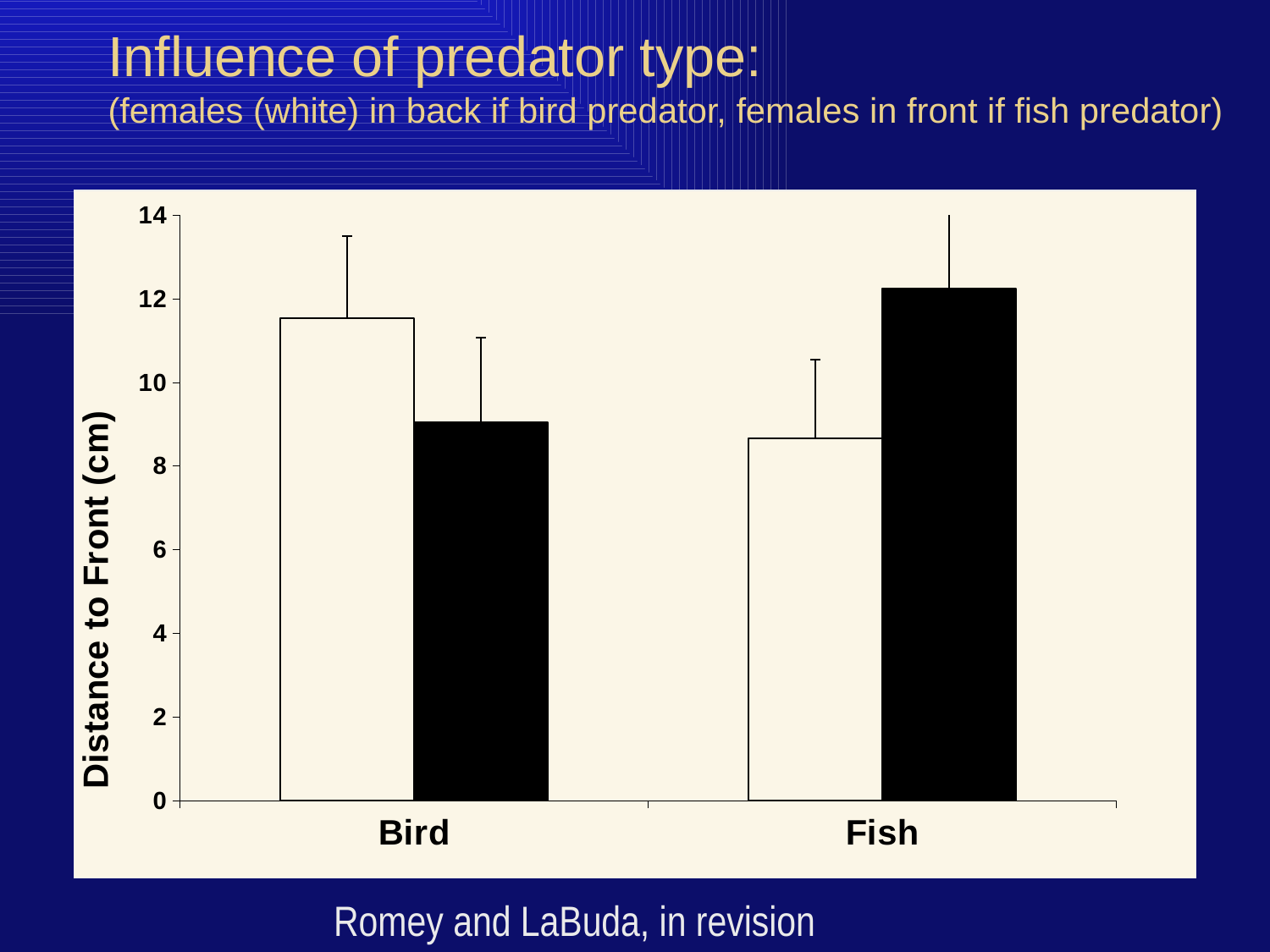
Is the value of the white bar for Fish greater or less than 10? less How many predator-type categories are shown on the x axis? 2 What are the two categories on the x axis? Bird and Fish Is the value of the black bar for Bird greater or less than 10? less For the Fish category, which bar is taller, the white bar or the black bar? the black bar What kind of chart is shown on the slide? bar chart For the Bird category, which bar is taller, the white bar or the black bar? the white bar Is the value of the white bar for Fish greater or less than 8? greater Which bar on the chart is the tallest? the black bar for Fish What is the label of the y axis? Distance to Front (cm)